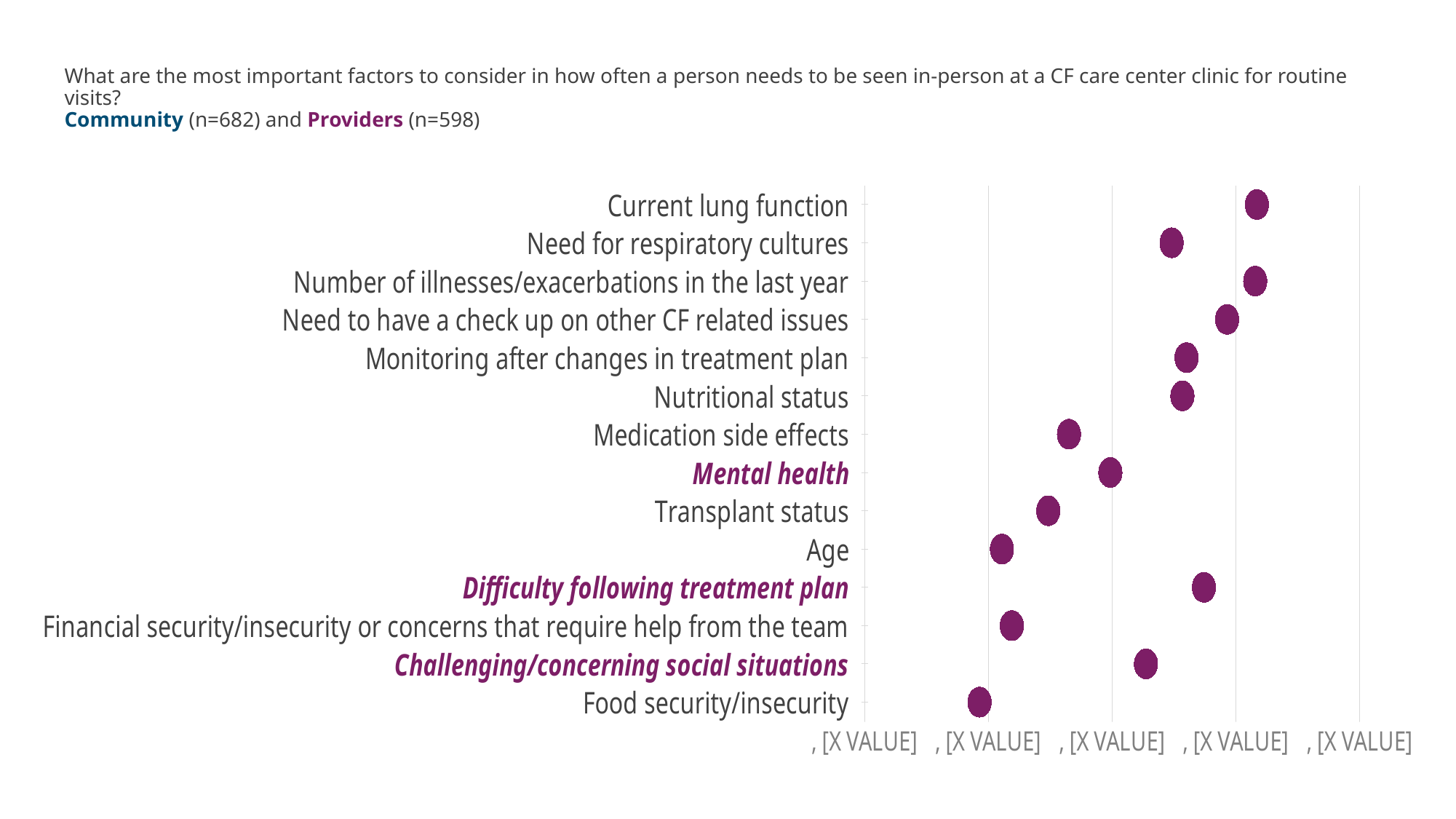
What kind of chart is shown on the slide? Dot plot Which three factor labels are shown in bold purple italics on the chart? Mental health; Difficulty following treatment plan; Challenging/concerning social situations Which has the larger value: Need to have a check up on other CF related issues or Nutritional status? Need to have a check up on other CF related issues Which factor has the lowest value on the chart? Food security/insecurity Which has the larger value: Need for respiratory cultures or Challenging/concerning social situations? Need for respiratory cultures Which has the larger value: Transplant status or Food security/insecurity? Transplant status What is the sample size given for Providers in the chart subtitle? n=598 How many factors (categories) are listed on the chart? 14